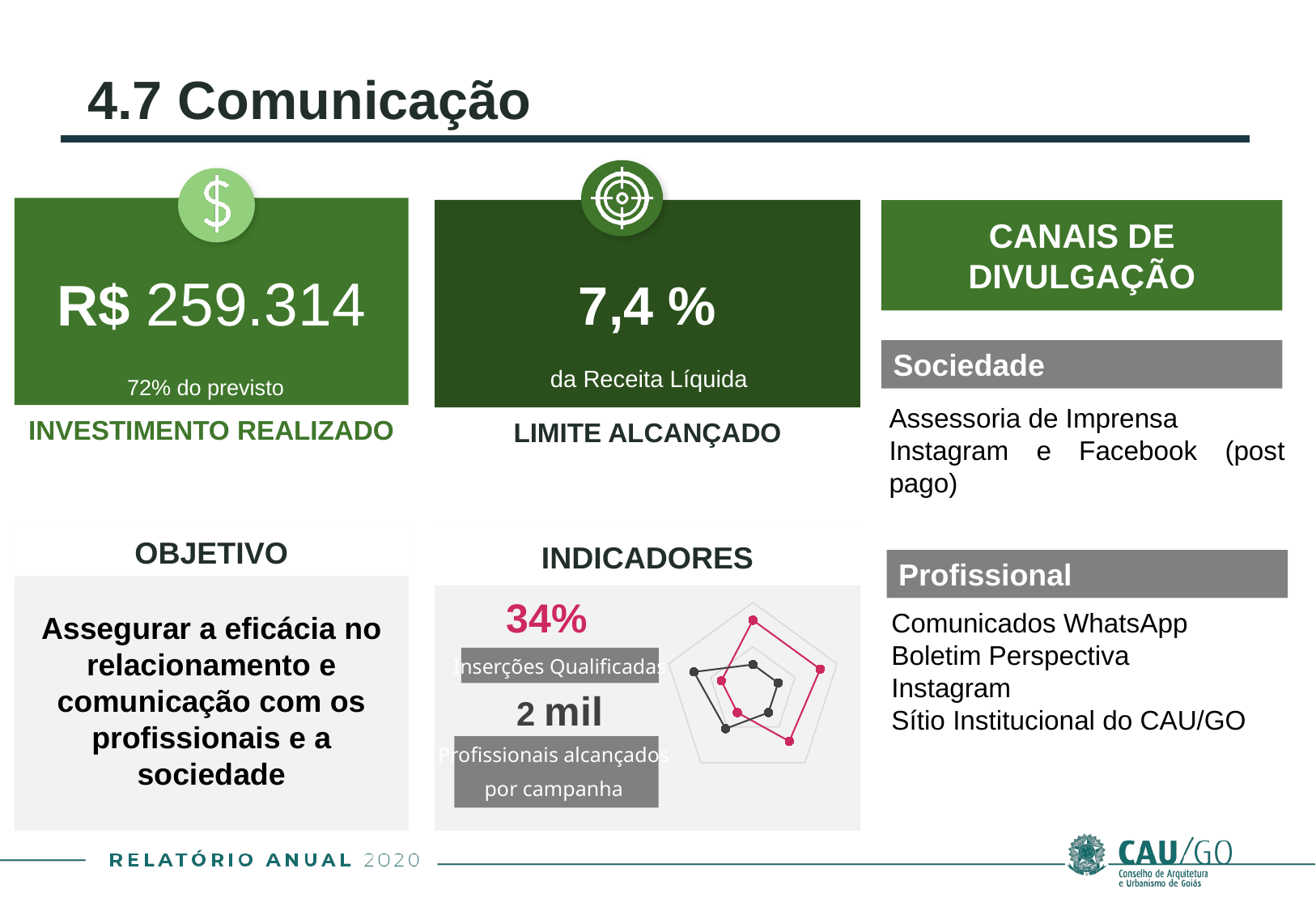
On the radar chart in the INDICADORES section, which series covers the larger area, the pink one or the dark grey one? the pink one What kind of chart is shown in the INDICADORES section of the slide? radar chart What two colours are used for the series on the radar chart in the INDICADORES section? pink and dark grey How many axes (points per series) does the radar chart in the INDICADORES section have? 5 Does the radar chart in the INDICADORES section display a legend? No How many data series are plotted on the radar chart in the INDICADORES section? 2